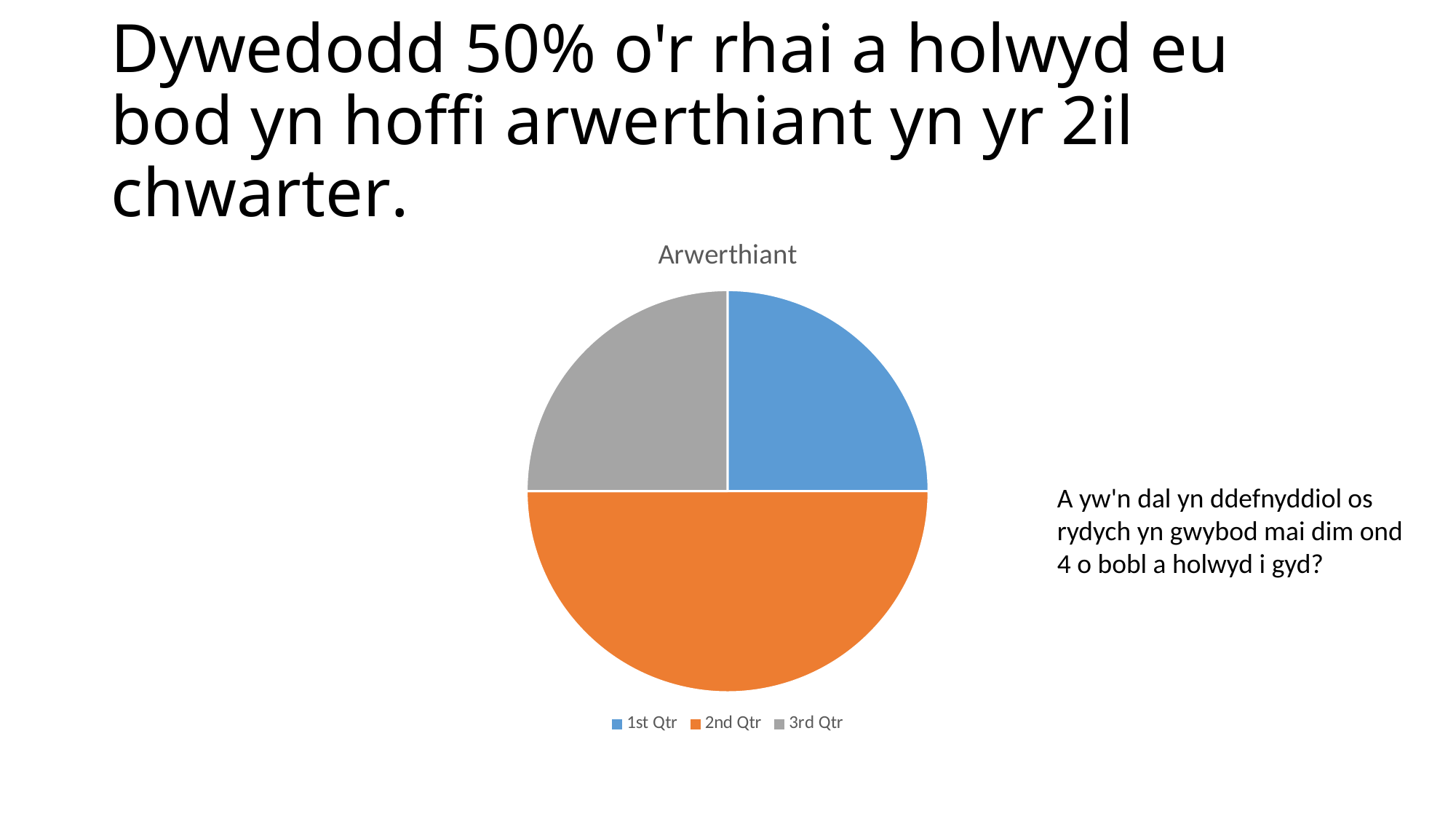
Which is larger, the slice for 3rd Qtr or the slice for 2nd Qtr? 2nd Qtr What share of the pie does the 2nd Qtr slice represent? 50% Which is larger, the slice for 1st Qtr or the slice for 2nd Qtr? 2nd Qtr How many entries does the chart legend list? 3 What is the title of the chart? Arwerthiant Which quarter has the largest slice of the pie? 2nd Qtr How many slices does the pie chart have? 3 What kind of chart is shown on the slide? pie chart What colour is the 2nd Qtr slice in the pie chart? orange